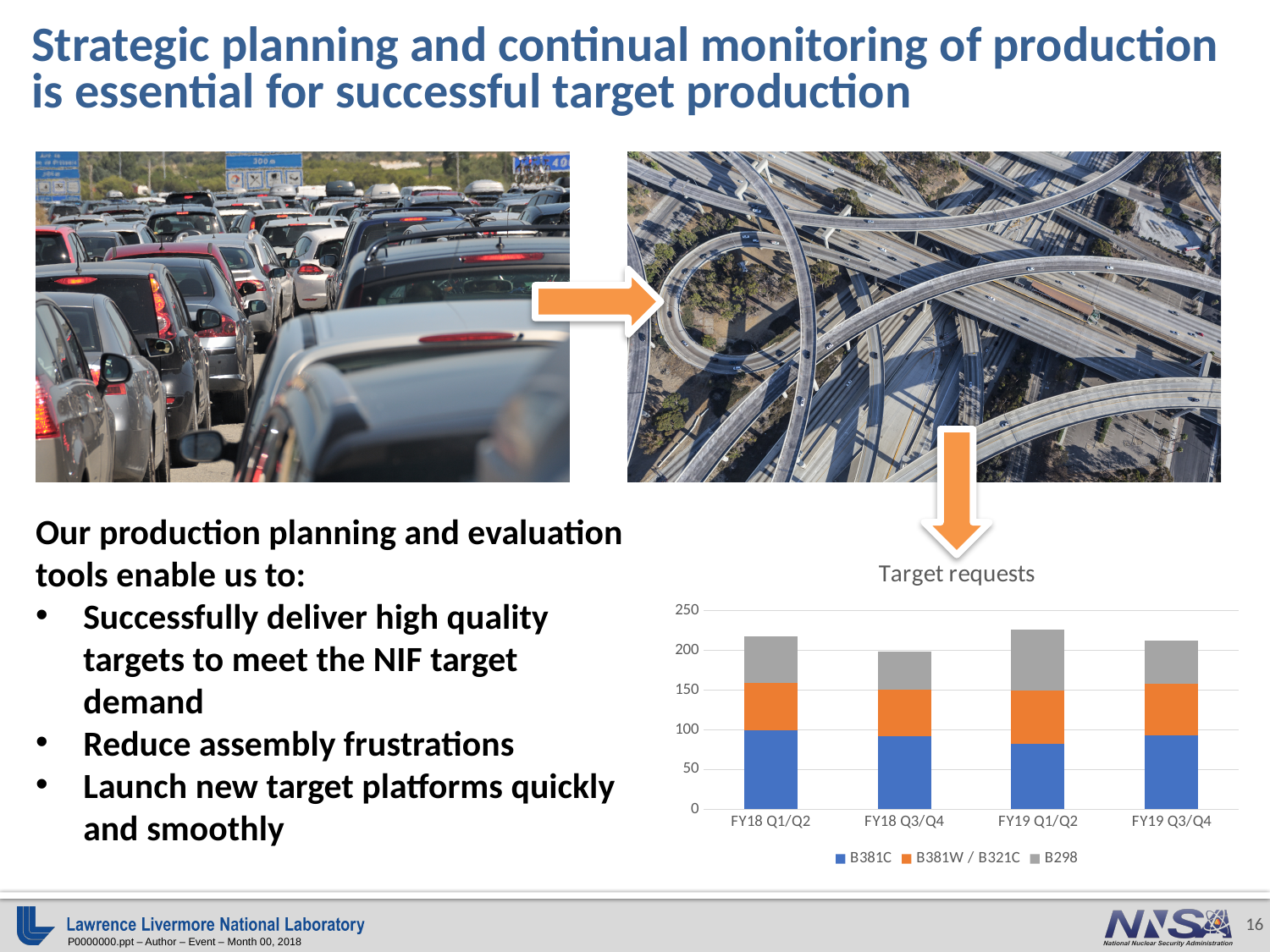
How many categories are shown on the x axis of the Target requests chart? 4 Is the total stacked bar for FY19 Q1/Q2 greater or less than 200? greater How many series does the legend of the Target requests chart list? 3 Which category has the lowest B381C value in the Target requests chart? FY19 Q1/Q2 Which category has the lowest total stacked bar in the Target requests chart? FY18 Q3/Q4 Is the total stacked bar for FY19 Q3/Q4 larger or smaller than the total for FY18 Q3/Q4? larger Which series is shown in orange in the Target requests chart? B381W / B321C What is the title of the chart on the slide? Target requests Is the total stacked bar for any category in the Target requests chart greater or less than 250? less What kind of chart is shown under the title "Target requests"? Stacked bar chart Is the total stacked bar for FY18 Q1/Q2 greater or less than 200? greater